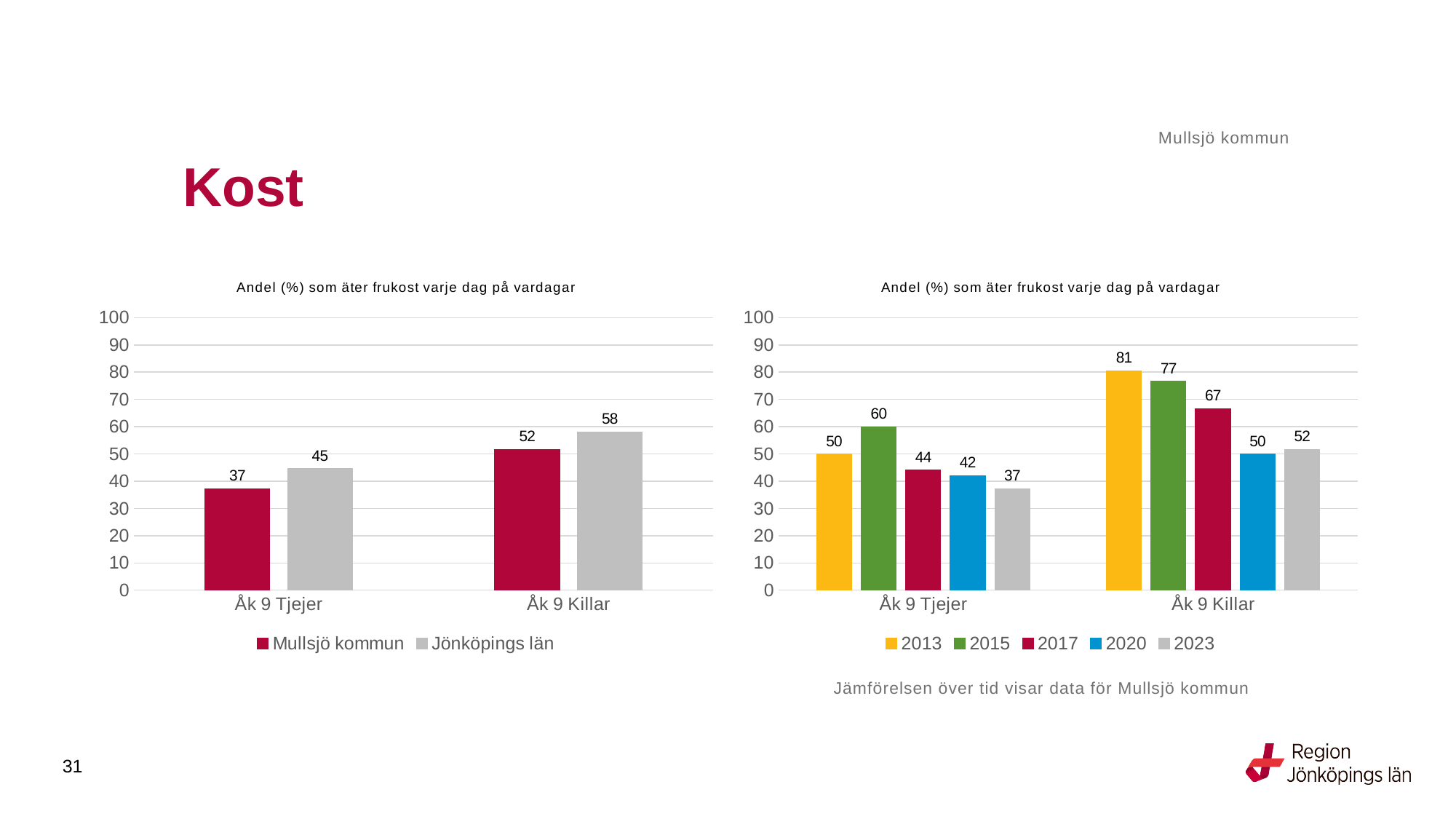
What type of chart is the right chart? Bar chart In the left chart, which is larger for Åk 9 Killar: Mullsjö kommun or Jönköpings län? Jönköpings län In the right chart, which year has the highest value for Åk 9 Tjejer? 2015 In the left chart, what is the value for Mullsjö kommun for Åk 9 Tjejer? 37 In the right chart, what is the difference between 2013 and 2023 for Åk 9 Killar? 29 In the left chart, what is the difference between Jönköpings län and Mullsjö kommun for Åk 9 Tjejer? 8 How many series does the legend of the left chart list? 2 In the right chart, which year has the lowest value for Åk 9 Killar? 2020 In the left chart, what is the value for Jönköpings län for Åk 9 Killar? 58 In the right chart, what is the value for 2023 for Åk 9 Tjejer? 37 In the right chart, what is the value for 2013 for Åk 9 Killar? 81 How many series does the legend of the right chart list? 5